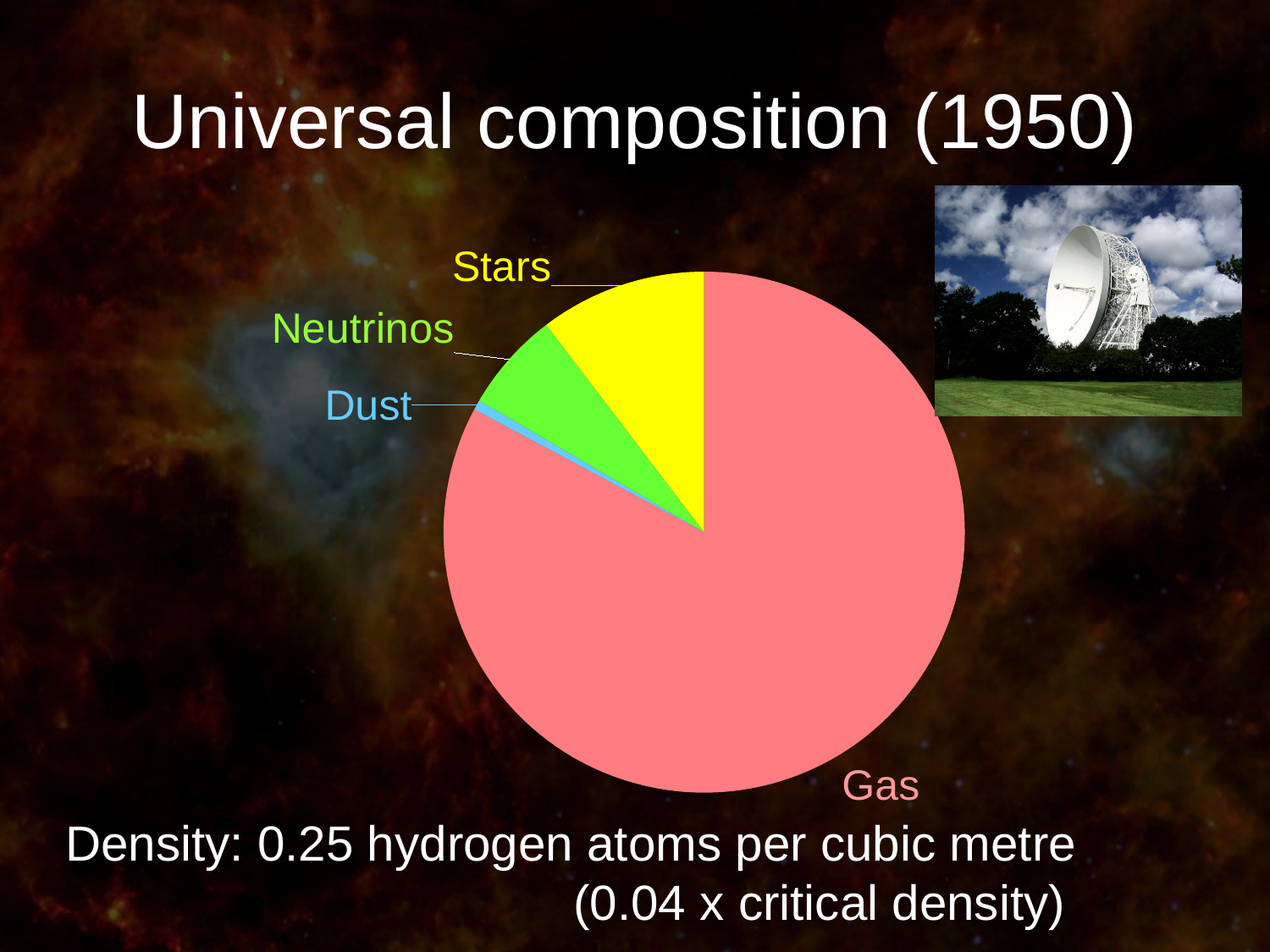
Which slice is larger, Gas or Stars? Gas Which slice is larger, Neutrinos or Dust? Neutrinos Which category has the largest slice of the pie chart? Gas What kind of chart is shown on the slide? pie chart Which category is shown in yellow on the pie chart? Stars What colour is the Neutrinos slice? green How many slices does the pie chart have? 4 Which category has the smallest slice of the pie chart? Dust Which slice is larger, Stars or Neutrinos? Stars Is the Gas slice more or less than half of the pie? more